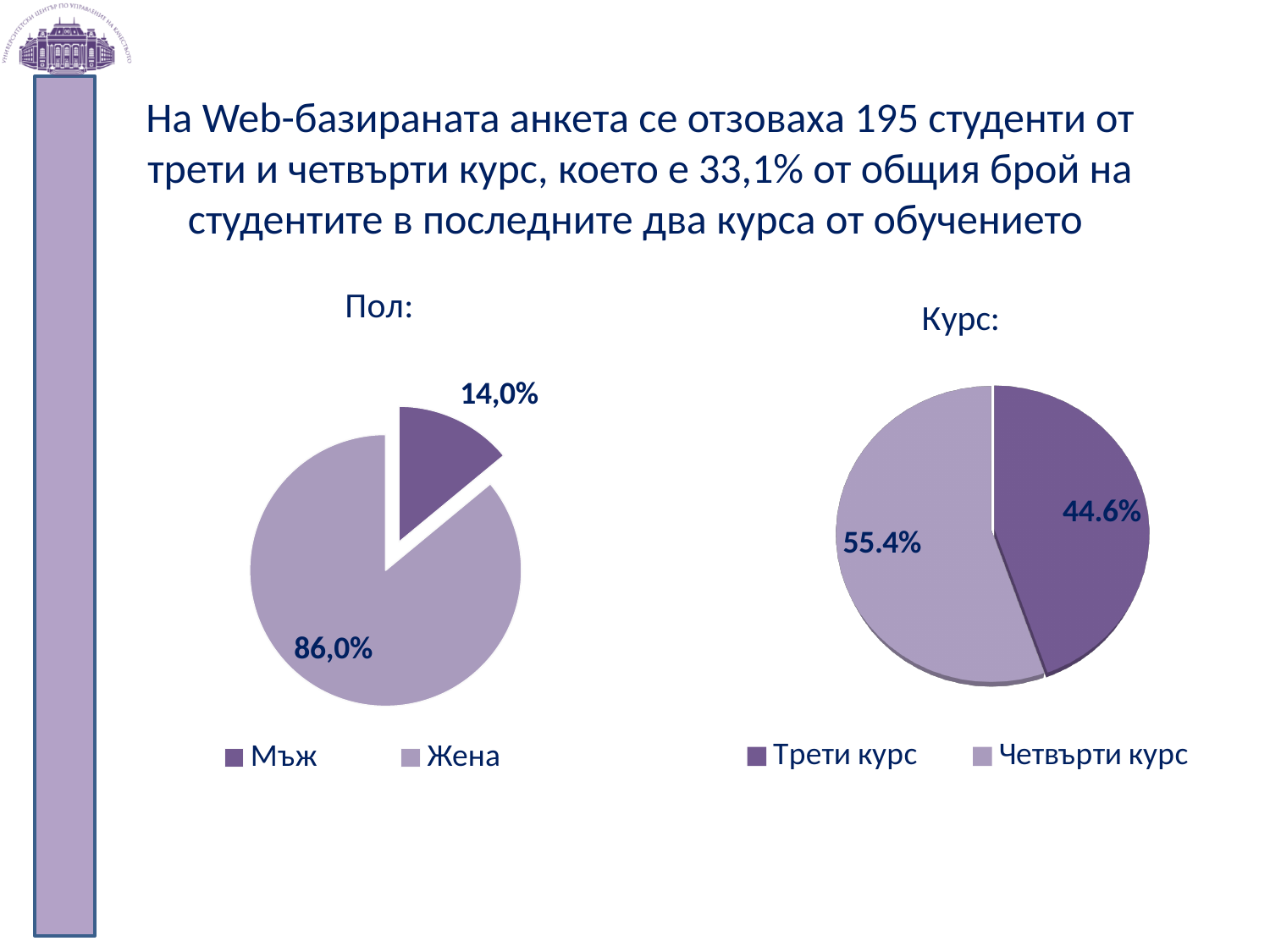
In the "Курс:" chart, which category has the smallest slice? Трети курс What are the legend entries of the "Пол:" chart? Мъж, Жена In the "Пол:" chart, what is the difference in percentage points between Жена and Мъж? 72,0% In the "Курс:" chart, what share is labelled for Четвърти курс? 55.4% In the "Курс:" chart, which is larger, Трети курс or Четвърти курс? Четвърти курс In the "Пол:" chart, which category has the largest slice? Жена In the "Курс:" chart, what share is labelled for Трети курс? 44.6% How many categories does the "Курс:" chart show? 2 In the "Курс:" chart, what is the difference in percentage points between Четвърти курс and Трети курс? 10.8% What kind of chart is the "Пол:" chart? Pie chart In the "Пол:" chart, what share is labelled for Мъж? 14,0% In the "Пол:" chart, what share is labelled for Жена? 86,0%